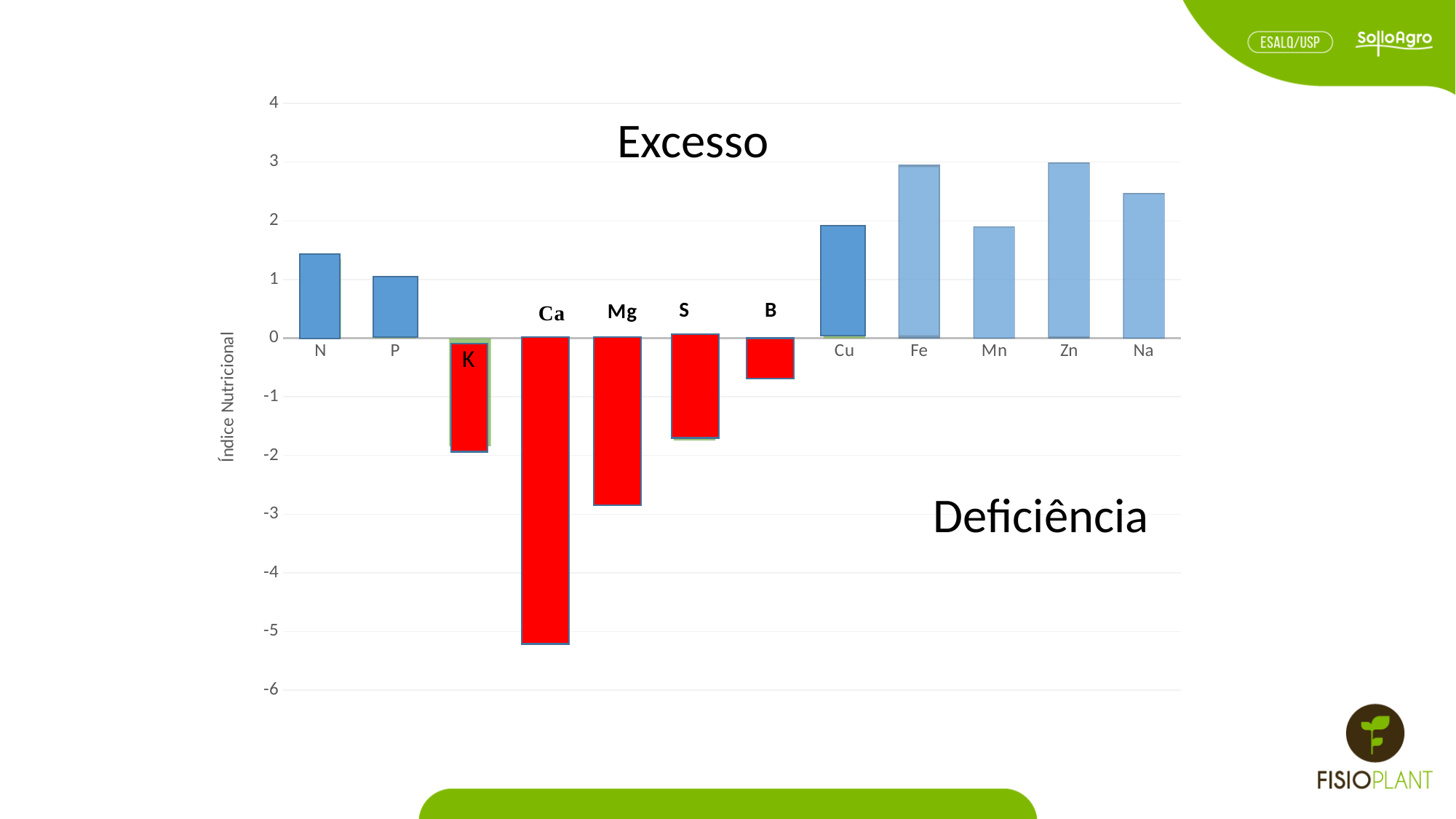
What is the title of the vertical axis? Índice Nutricional How many nutrients have negative (deficiency) values? 5 Which has the lower value, Ca or Mg? Ca Which nutrient has the lowest (most negative) value? Ca Is the value for Ca greater or less than -5? less Is the value for N greater or less than 1? greater Is the value for Na greater or less than 2? greater How many nutrient categories are plotted on the x axis? 12 Which has the larger value, Fe or Mn? Fe What kind of chart is shown on the slide? bar chart